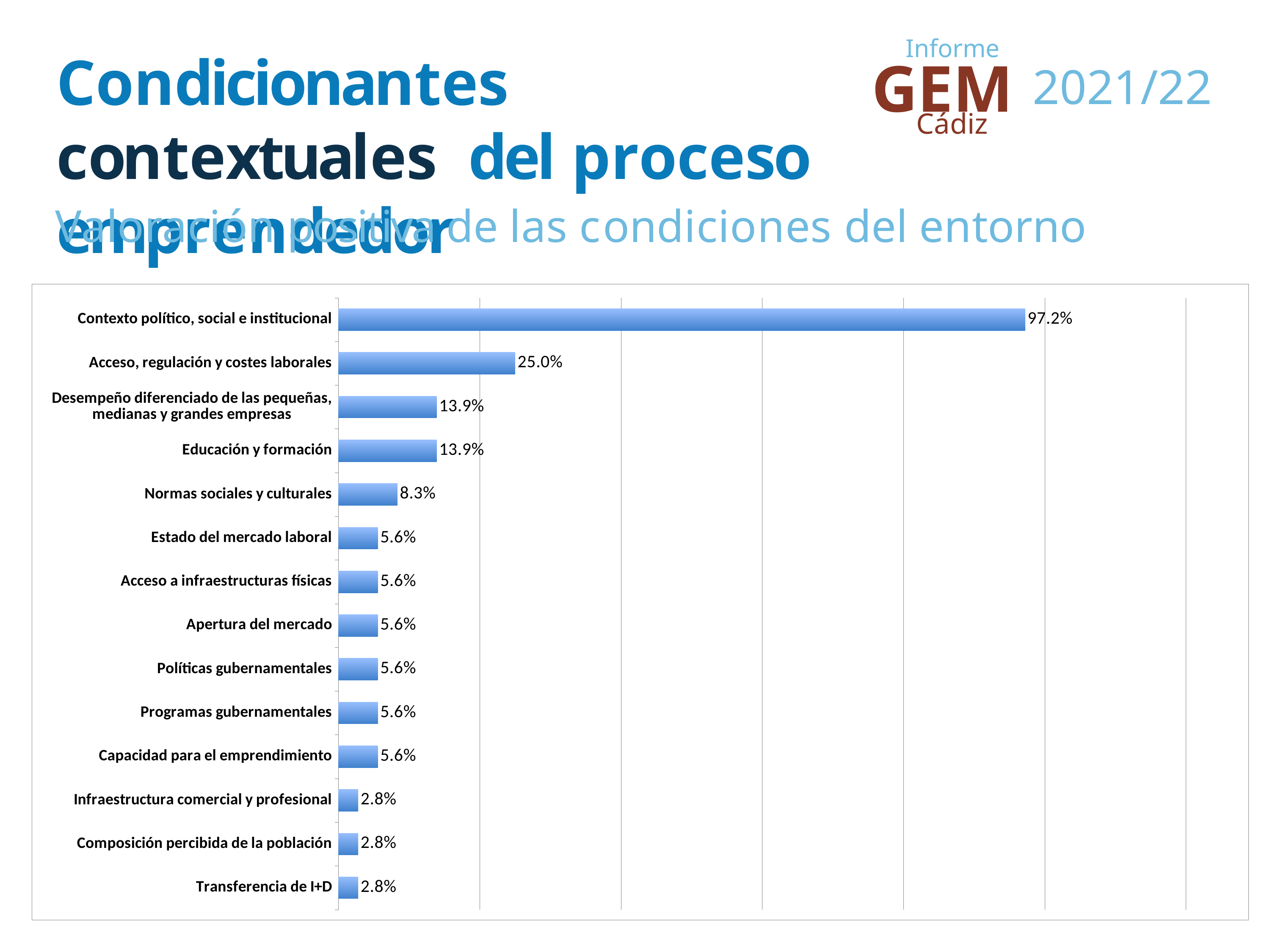
Which category has the highest value? Contexto político, social e institucional What is the value for Normas sociales y culturales? 8.3% What kind of chart is shown on the slide? Bar chart How many categories have a value of 2.8%? 3 Which is larger, the value for Normas sociales y culturales or the value for Estado del mercado laboral? Normas sociales y culturales What is the value for Educación y formación? 13.9% How many categories are shown in the chart? 14 What is the difference between the values for Contexto político, social e institucional and Acceso, regulación y costes laborales? 72.2% What is the value for Contexto político, social e institucional? 97.2% What is the difference between the values for Acceso, regulación y costes laborales and Educación y formación? 11.1% What is the value for Acceso, regulación y costes laborales? 25.0% What is the value for Transferencia de I+D? 2.8%